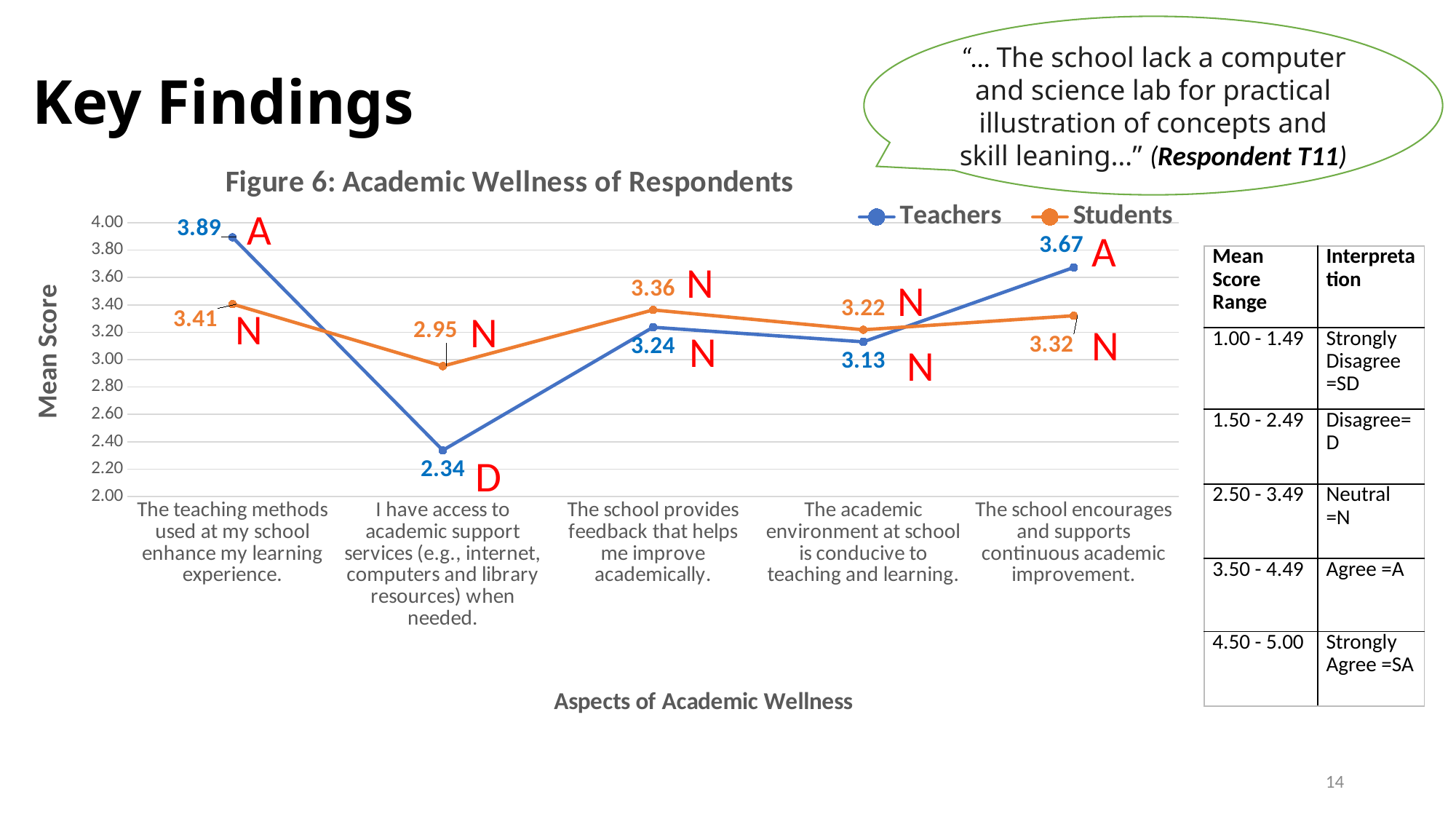
How many series does the legend list? 2 What is the title of the chart? Figure 6: Academic Wellness of Respondents For "The school provides feedback that helps me improve academically.", which series has the higher mean score, Teachers or Students? Students Which aspect has the lowest Teachers mean score? I have access to academic support services (e.g., internet, computers and library resources) when needed. How many aspects of academic wellness are plotted on the x axis? 5 What is the Teachers mean score for "The teaching methods used at my school enhance my learning experience."? 3.89 What kind of chart is Figure 6? Line chart Which aspect has the highest Students mean score? The teaching methods used at my school enhance my learning experience. What is the Students mean score for "I have access to academic support services (e.g., internet, computers and library resources) when needed."? 2.95 What is the Teachers mean score for "The school encourages and supports continuous academic improvement."? 3.67 Is the Teachers mean score for "The academic environment at school is conducive to teaching and learning." greater or less than 3.00? greater What is the difference between the Students and Teachers mean scores for "I have access to academic support services (e.g., internet, computers and library resources) when needed."? 0.61